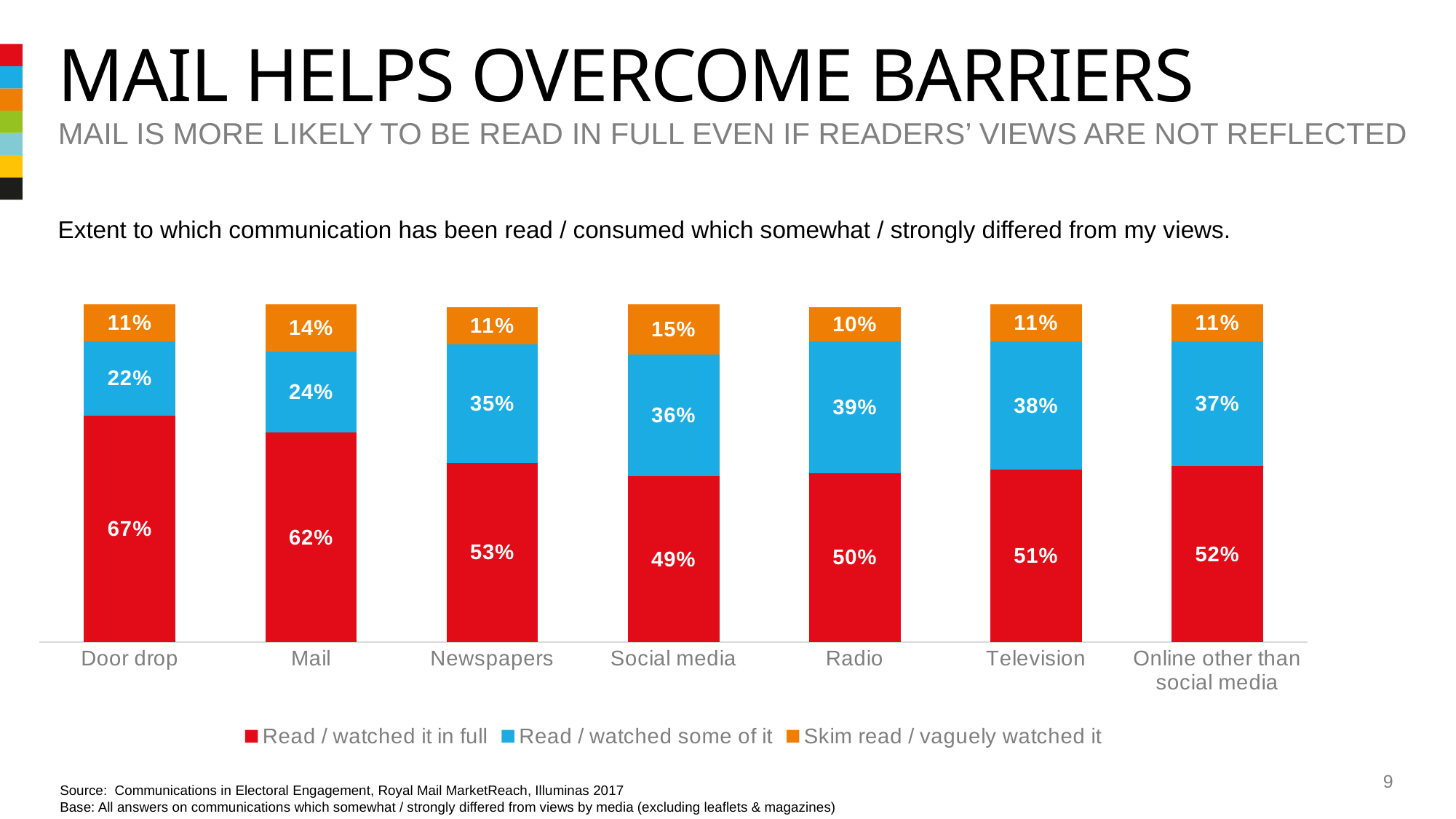
What is the total of the stacked bar for Newspapers? 99% What percentage of Door drop communications were read / watched in full? 67% What is the 'Read / watched some of it' value for Radio? 39% Which category has the highest 'Read / watched it in full' value? Door drop How many media categories are shown on the x axis? 7 Which is larger: the 'Read / watched some of it' value for Mail or for Newspapers? Newspapers How many series does the legend list? 3 Which category has the lowest 'Read / watched it in full' value? Social media What is the difference between the 'Read / watched it in full' values for Door drop and Mail? 5% What is the 'Skim read / vaguely watched it' value for Social media? 15% What kind of chart is shown on the slide? Stacked bar chart Which category has the lowest 'Skim read / vaguely watched it' value? Radio